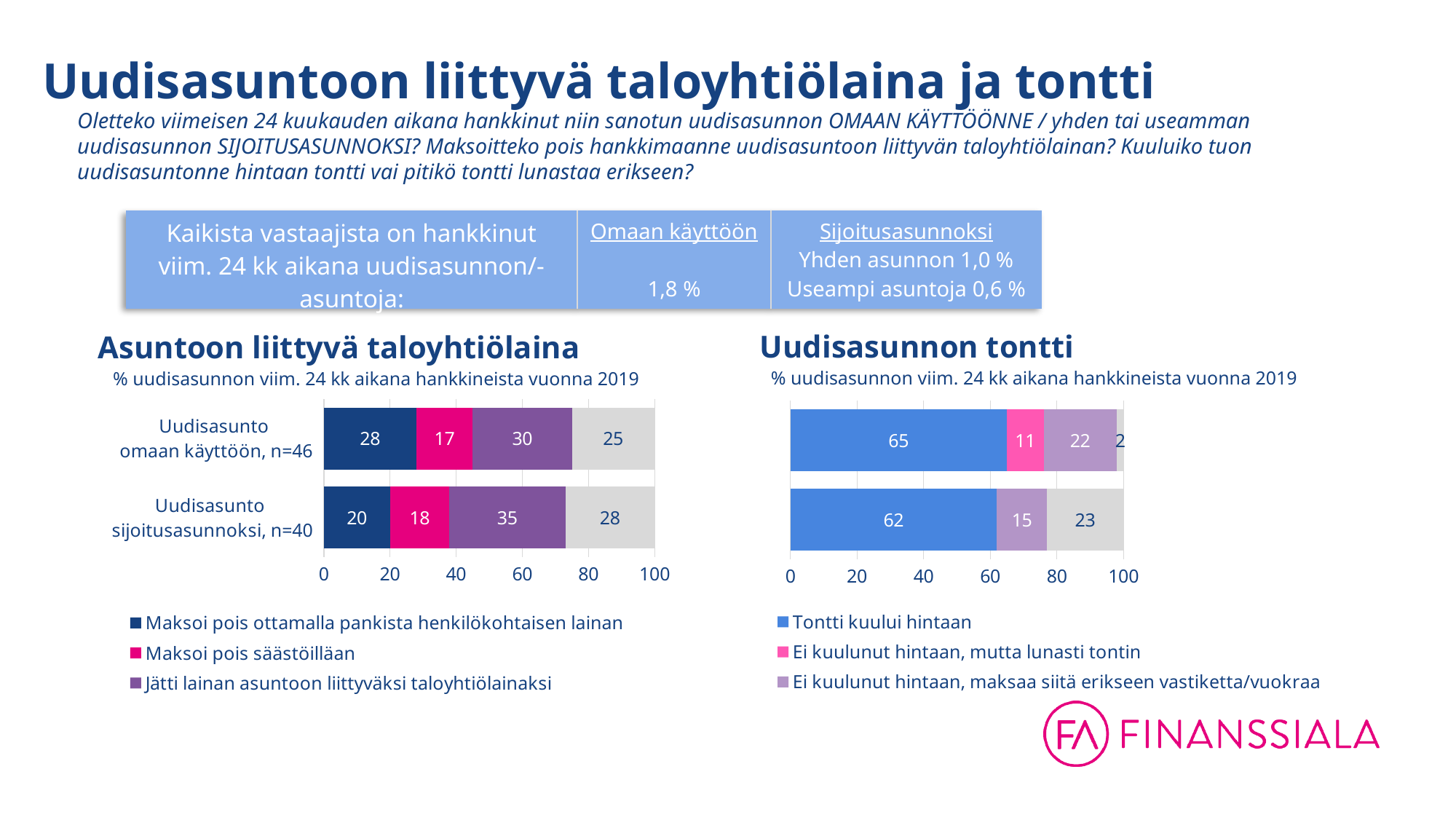
In the chart 'Uudisasunnon tontti', what is the difference between the 'Tontti kuului hintaan' values of the top and bottom bars? 3 In the chart 'Asuntoon liittyvä taloyhtiölaina', what is the value of 'Jätti lainan asuntoon liittyväksi taloyhtiölainaksi' for 'Uudisasunto sijoitusasunnoksi, n=40'? 35 How many series does the legend of the chart 'Asuntoon liittyvä taloyhtiölaina' list? 3 In the chart 'Asuntoon liittyvä taloyhtiölaina', what is the value of 'Maksoi pois ottamalla pankista henkilökohtaisen lainan' for 'Uudisasunto omaan käyttöön, n=46'? 28 In the chart 'Uudisasunnon tontti', which legend entry is shown in light blue? Tontti kuului hintaan In the chart 'Uudisasunnon tontti', what is the value of 'Tontti kuului hintaan' in the top bar? 65 In the chart 'Uudisasunnon tontti', what is the value of 'Ei kuulunut hintaan, maksaa siitä erikseen vastiketta/vuokraa' in the bottom bar? 15 What kind of chart is 'Uudisasunnon tontti'? Stacked bar chart In the chart 'Asuntoon liittyvä taloyhtiölaina', which category has the larger value for 'Jätti lainan asuntoon liittyväksi taloyhtiölainaksi'? Uudisasunto sijoitusasunnoksi, n=40 In the chart 'Asuntoon liittyvä taloyhtiölaina', what is the difference between the 'Maksoi pois ottamalla pankista henkilökohtaisen lainan' values for the two categories? 8 How many bars does the chart 'Uudisasunnon tontti' show? 2 In the chart 'Asuntoon liittyvä taloyhtiölaina', what is the value of 'Maksoi pois säästöillään' for 'Uudisasunto sijoitusasunnoksi, n=40'? 18